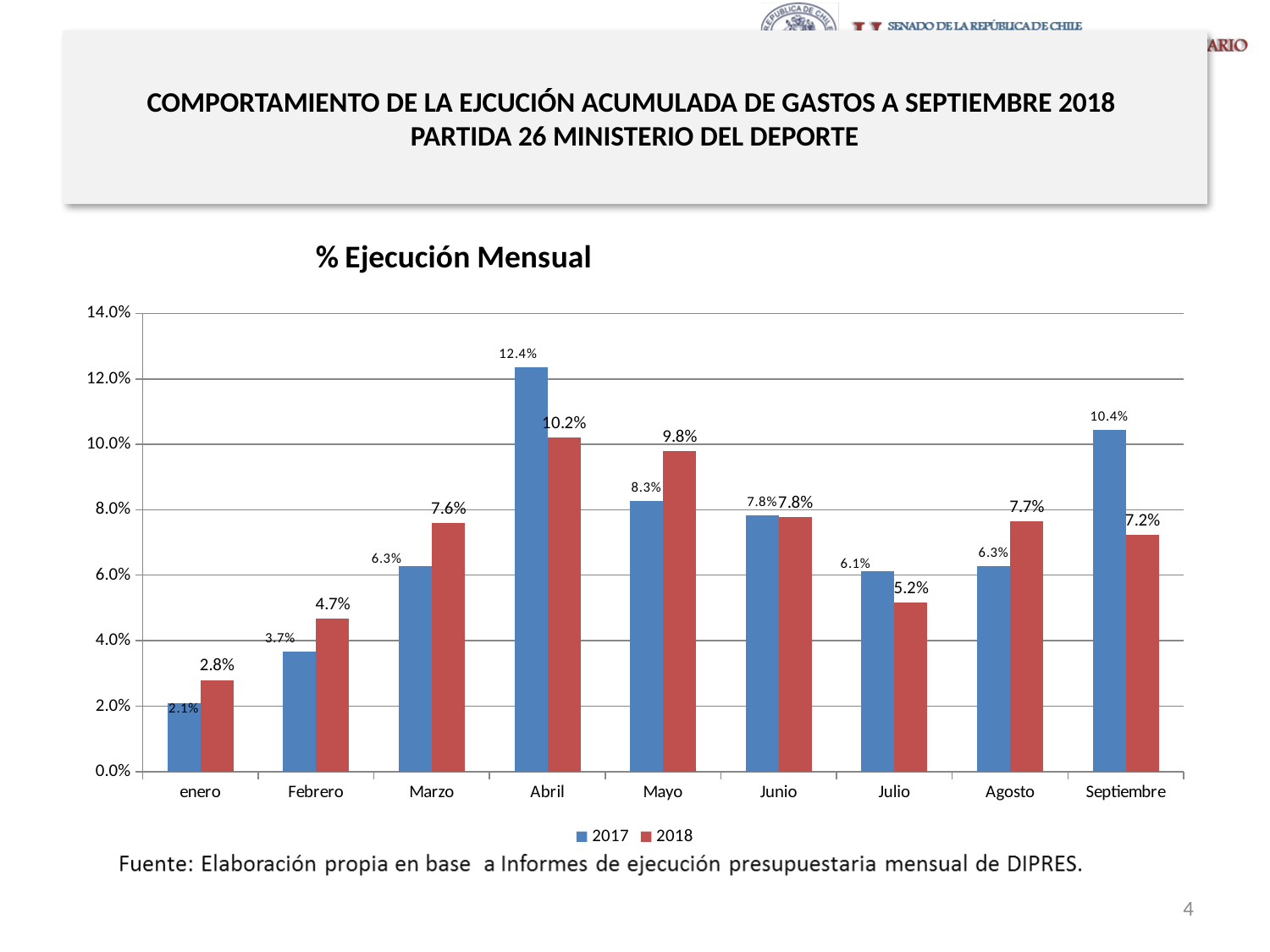
Do the 2018 values rise or fall from enero to Mayo? rise, except for a dip in Mayo after Abril Which month has the highest value for the 2017 series? Abril What is the difference between the 2017 and 2018 values in Septiembre? 3.2% Which month has the lowest value for the 2018 series? enero How many series does the legend list? 2 What is the title of the chart? % Ejecución Mensual What kind of chart is shown on the slide? bar chart What is the value for 2018 in Mayo? 9.8% How many months are shown on the x axis? 9 What is the value for 2017 in Abril? 12.4% Which is larger in Julio, the 2017 value or the 2018 value? 2017 What is the value for 2018 in enero? 2.8%